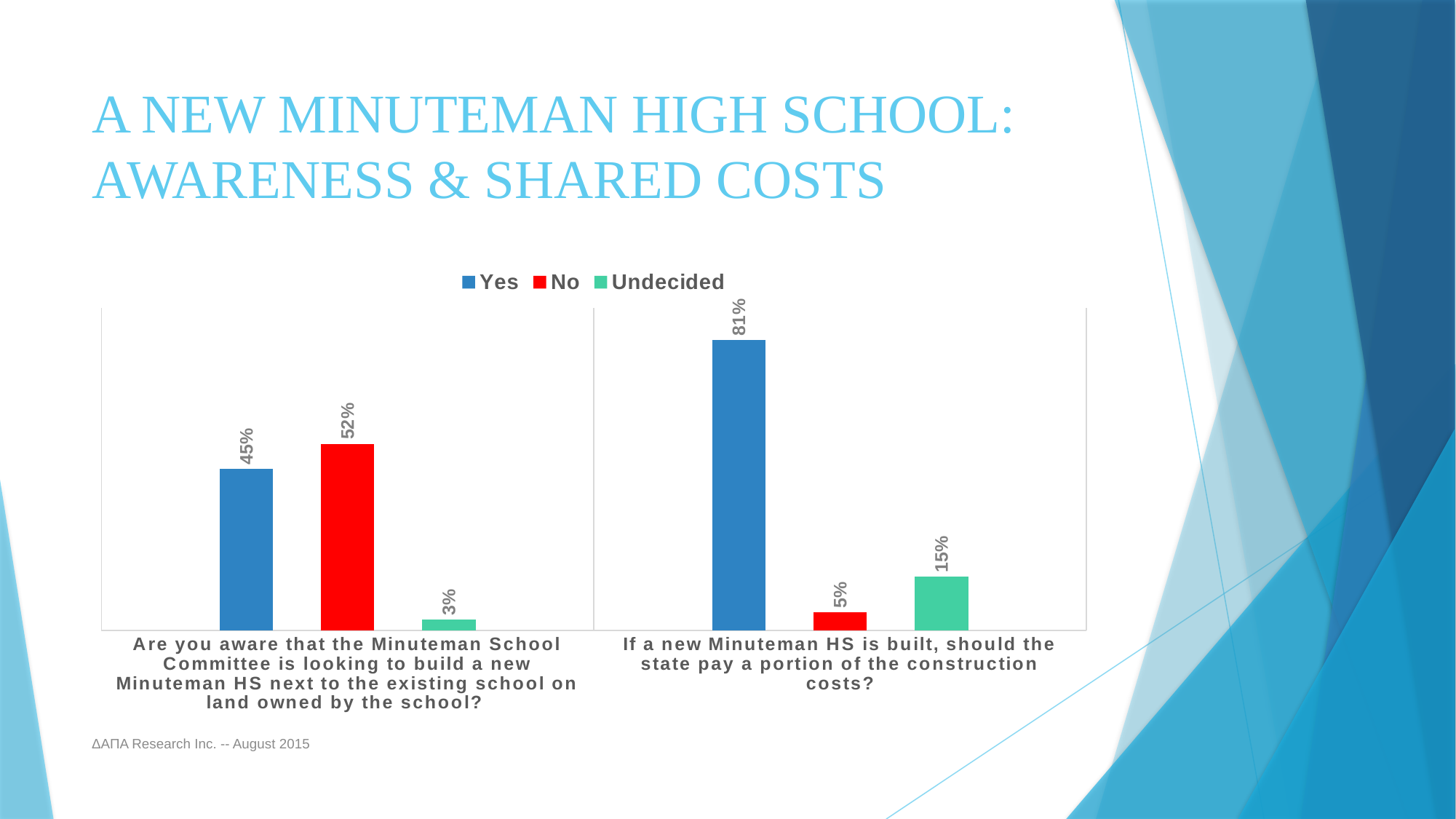
What is the difference between the No and Yes percentages for the awareness question? 7% What percentage answered Yes to whether the state should pay a portion of the construction costs? 81% What kind of chart is shown on the slide? Bar chart What colour represents the No responses in the chart? Red For the awareness question, which is larger: the Yes percentage or the No percentage? No What percentage answered No to the question about being aware of the plan to build a new Minuteman HS? 52% How many series does the legend list? 3 Which response has the lowest value for the awareness question about building a new Minuteman HS? Undecided What is the difference between the Undecided and No percentages for the question about the state paying a portion of construction costs? 10% What percentage answered Yes to the question about being aware that the Minuteman School Committee is looking to build a new Minuteman HS? 45% What percentage were Undecided on whether the state should pay a portion of the construction costs if a new Minuteman HS is built? 15% Which response has the highest value for the question about whether the state should pay a portion of the construction costs? Yes